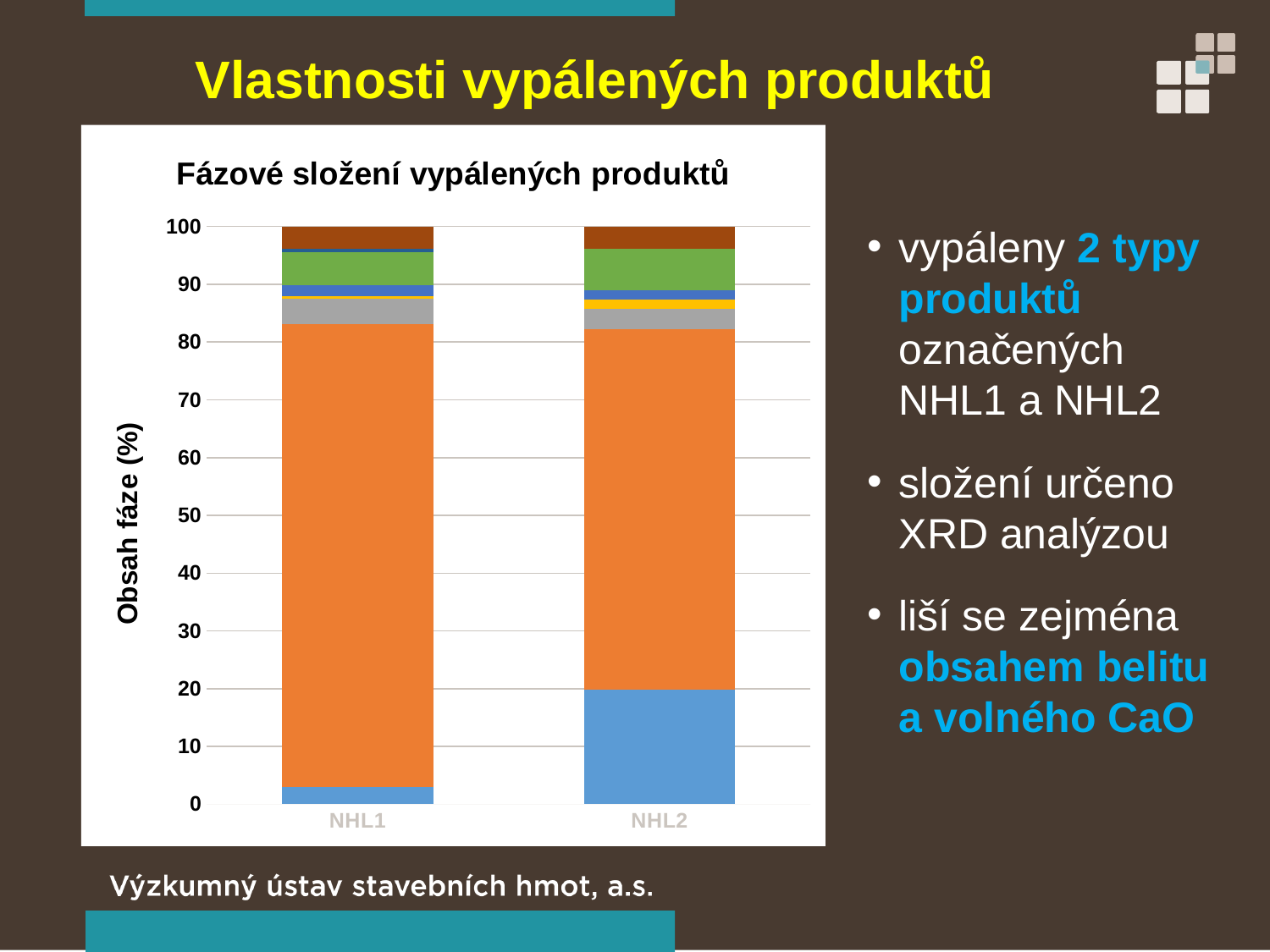
Is the bottom (blue) segment of the NHL1 bar greater or less than 10? less How many categories are shown on the x axis of the chart? 2 What kind of chart is shown on the slide? stacked bar chart Is the top of the orange segment in the NHL2 bar greater or less than 90? less What is the label of the vertical axis of the chart? Obsah fáze (%) Is the top of the orange segment in the NHL1 bar greater or less than 80? greater What is the total height of the stacked bar for NHL1? 100 Which bar has the larger orange segment, NHL1 or NHL2? NHL1 What is the title of the chart? Fázové složení vypálených produktů What is the total height of the stacked bar for NHL2? 100 Which bar has the larger bottom (blue) segment, NHL1 or NHL2? NHL2